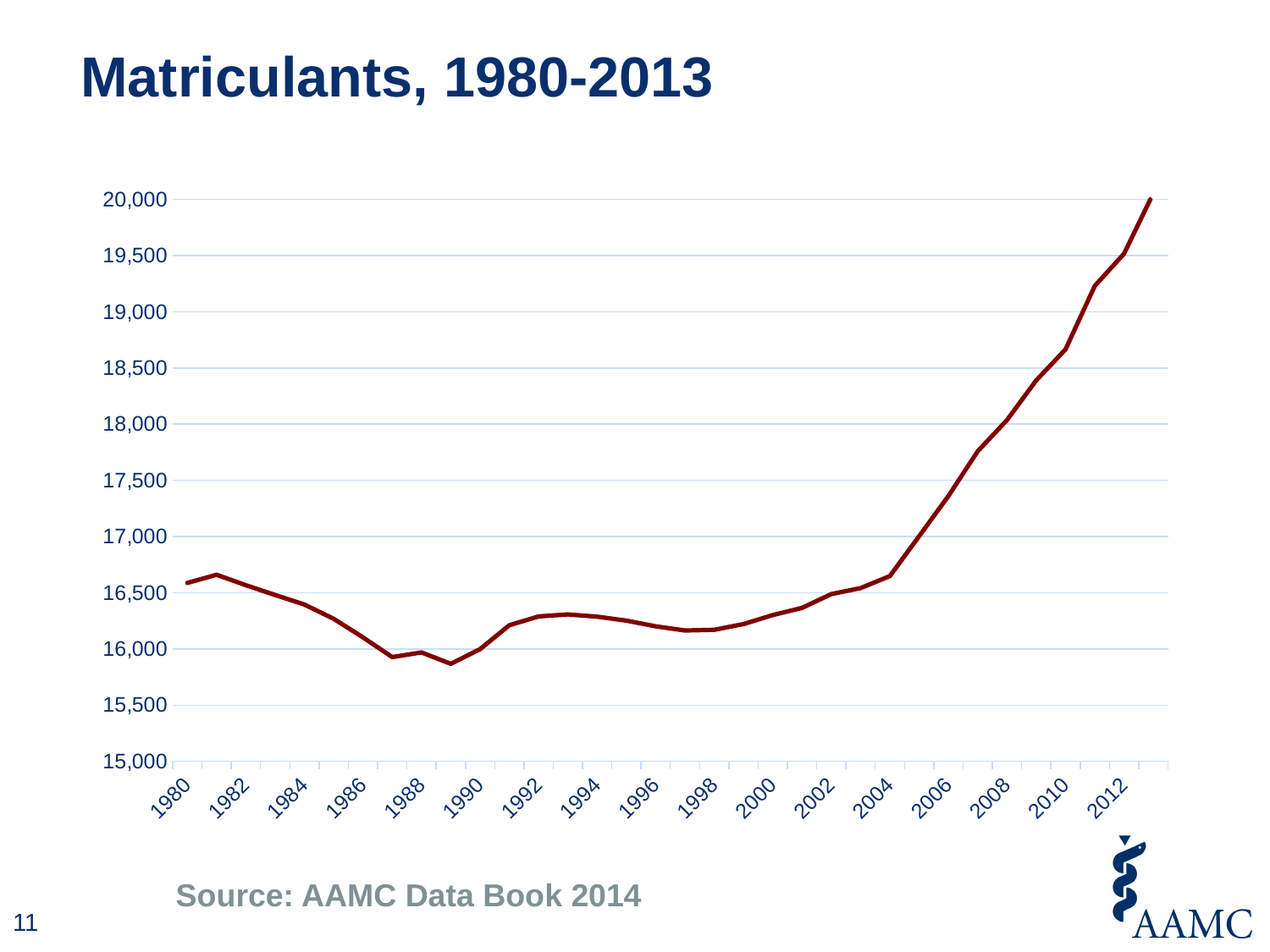
What is the title of the chart? Matriculants, 1980-2013 Do the values rise or fall between 1980 and 1989? fall Is the value for 2000 greater or less than 16,500? less Which year has the larger value, 1990 or 2004? 2004 Do the values rise or fall between 2004 and 2013? rise Which year has the larger value, 1980 or 2012? 2012 Is the value for 2006 greater or less than 17,000? greater Is the value for 2012 greater or less than 19,000? greater What source is cited for the chart? AAMC Data Book 2014 What kind of chart is shown on the slide? line chart In which year is the number of matriculants highest? 2013